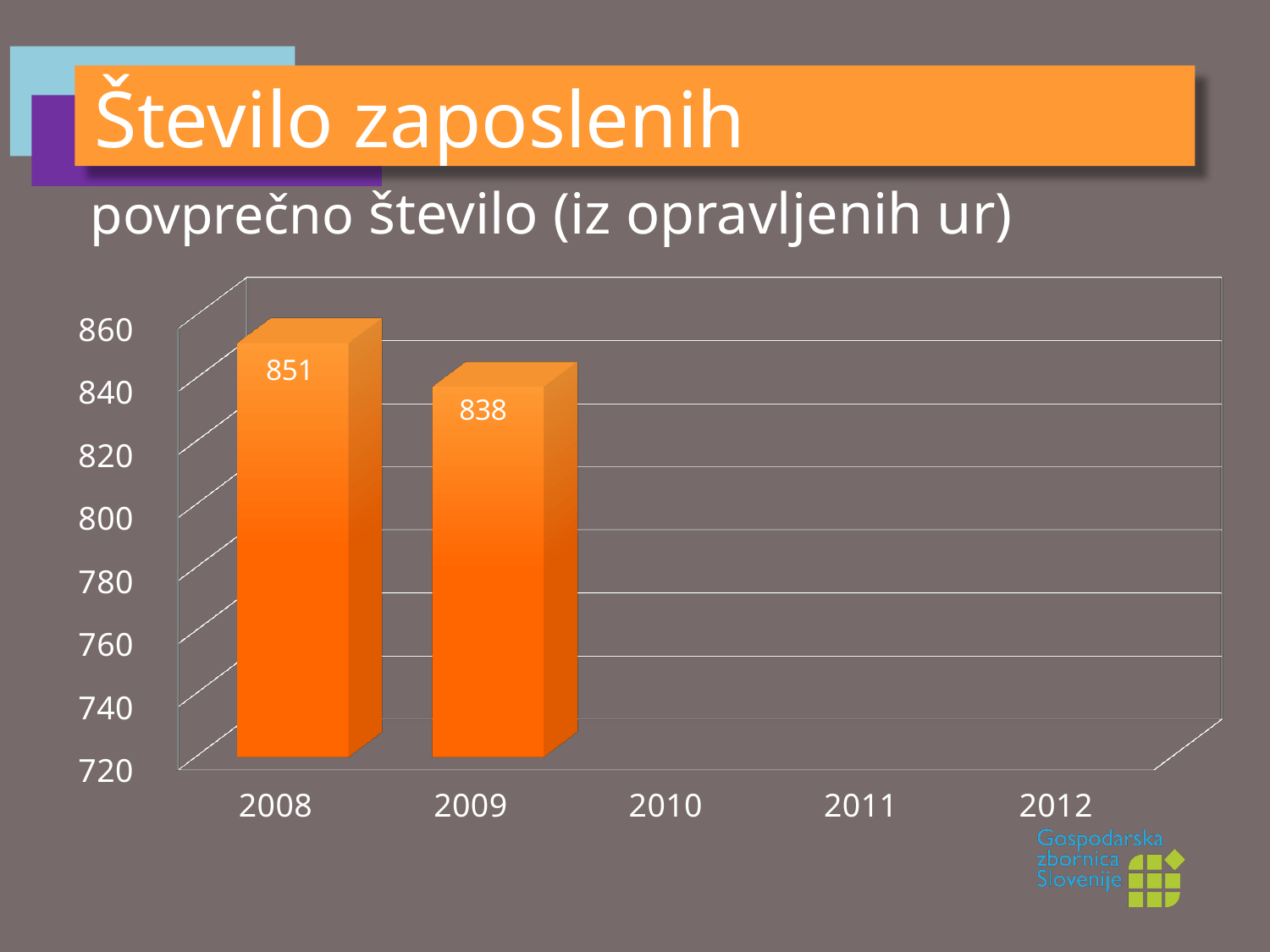
What is the value for 2009? 838 What is the difference between the values for 2008 and 2009? 13 Which year has the highest value shown? 2008 Is the value for 2009 greater or less than 820? greater How many years are labelled on the x axis? 5 What is the value for 2008? 851 Do the values rise or fall from 2008 to 2009? fall Is the value for 2008 greater or less than 840? greater What kind of chart is shown on the slide? bar chart Which year with a plotted bar has the lowest value? 2009 How many bars are plotted in the chart? 2 Which is larger, the value for 2008 or the value for 2009? 2008